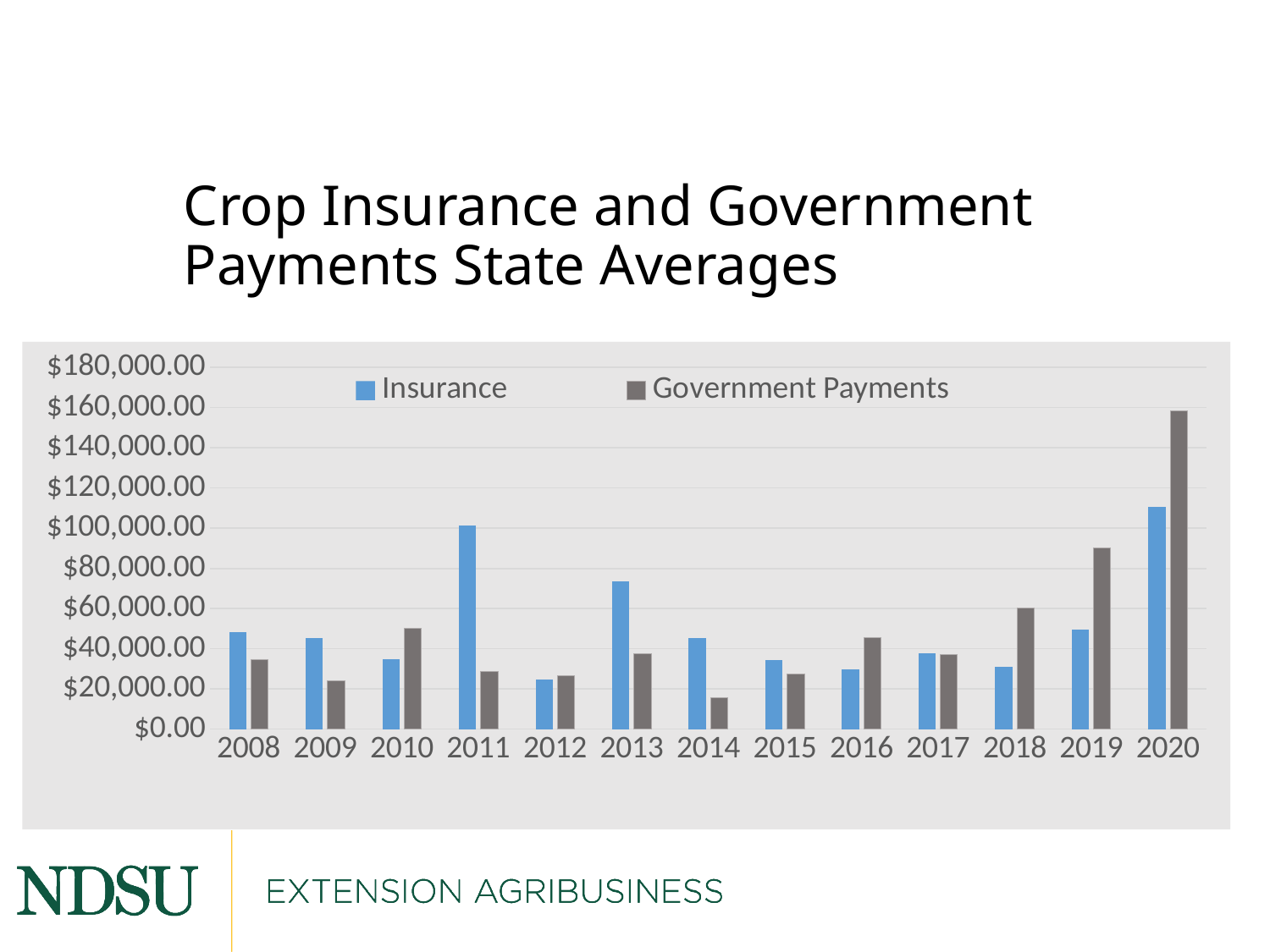
Is the Insurance value for 2011 greater or less than $80,000.00? greater In 2018, which is larger: Insurance or Government Payments? Government Payments Is the Government Payments value for 2020 greater or less than $140,000.00? greater In which year is the Insurance value highest? 2020 Is the Government Payments value for 2014 greater or less than $20,000.00? less In which year is the Government Payments value highest? 2020 How many years are shown on the x axis? 13 How many series does the legend list? 2 Do Government Payments rise or fall from 2017 to 2020? Rise What kind of chart is shown on the slide? Bar chart In 2011, which is larger: Insurance or Government Payments? Insurance In which year is the Government Payments value lowest? 2014